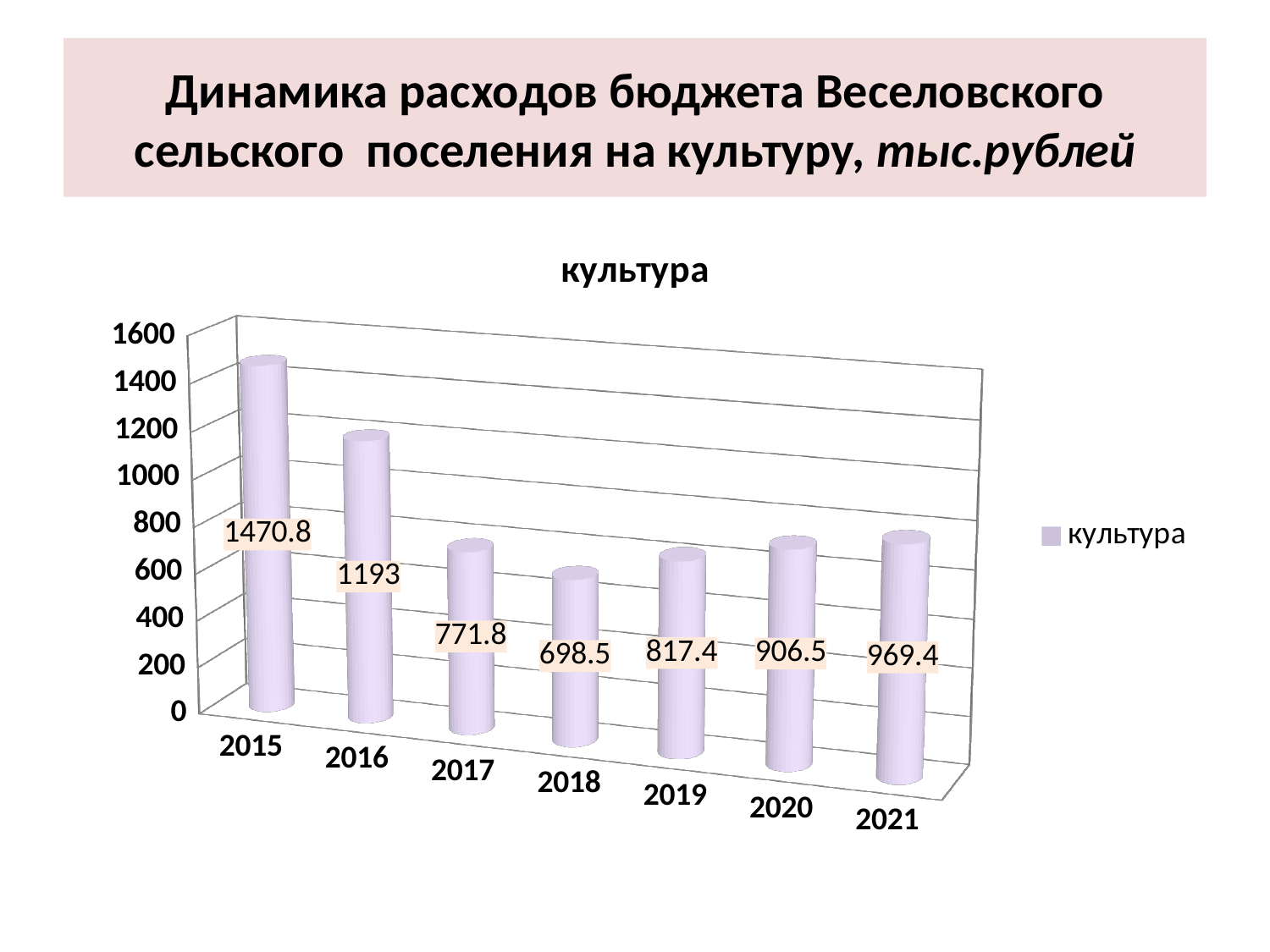
How many years are shown on the x axis? 7 What is the difference between the values for 2015 and 2016? 277.8 Which is larger, the value for 2017 or the value for 2019? 2019 What is the value for 2018? 698.5 Is the value for 2016 greater or less than 1000? greater What is the value for 2015? 1470.8 What is the difference between the values for 2021 and 2020? 62.9 Do the values rise or fall from 2018 to 2021? rise Which year has the lowest value? 2018 Which year has the highest value? 2015 What is the value for 2021? 969.4 What kind of chart is this? bar chart